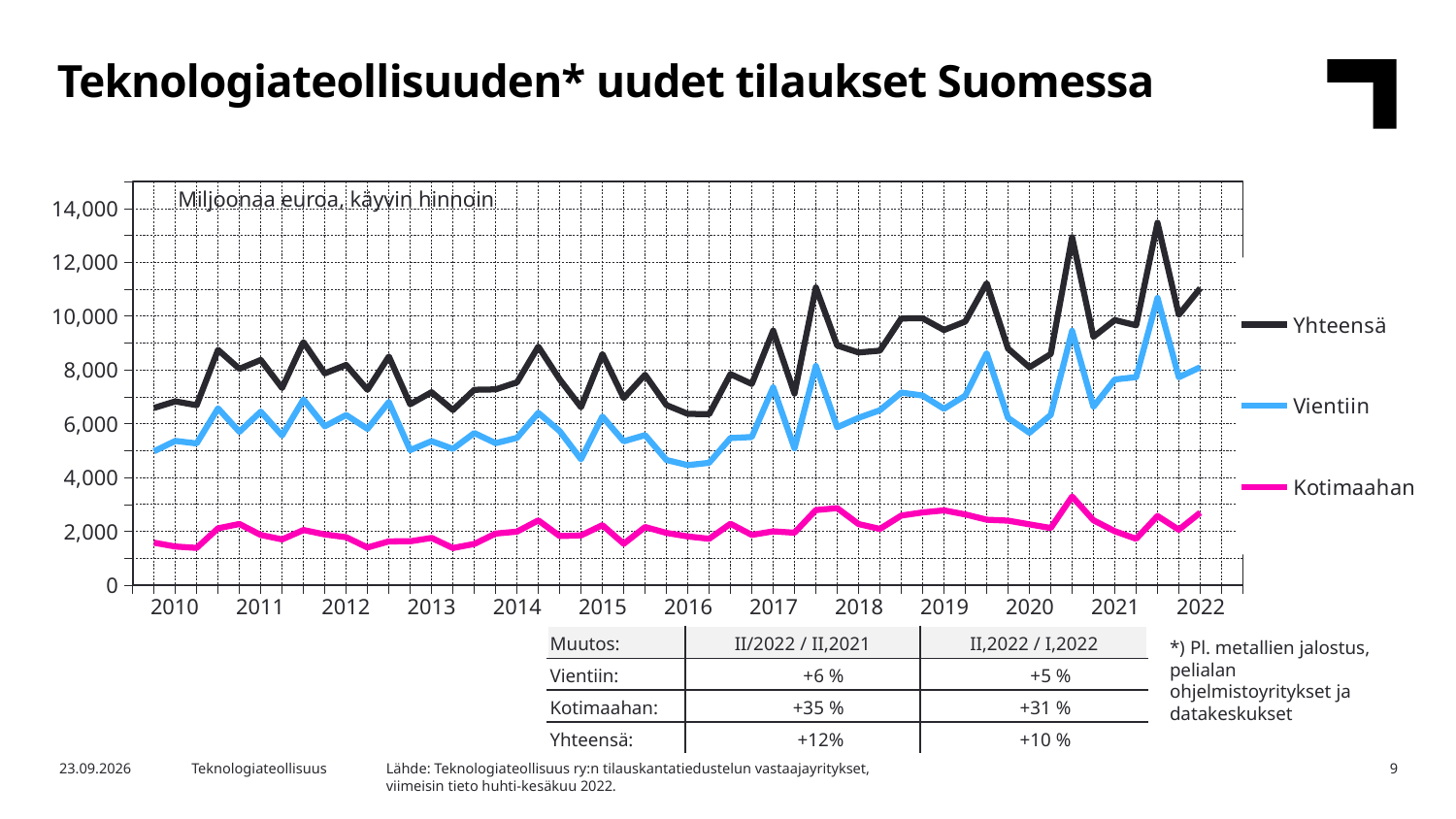
Which series are listed in the legend? Yhteensä, Vientiin, Kotimaahan Is the Kotimaahan value at the start of 2010 greater or less than 2,000? less Is the peak value of the Vientiin line in 2021 greater or less than 10,000? greater Which series has the lowest values throughout the chart? Kotimaahan How many years are labelled on the x axis? 13 Which series has the highest values throughout the chart? Yhteensä What kind of chart is shown on the slide? Line chart What unit is stated inside the chart area? Miljoonaa euroa, käyvin hinnoin Is the lowest Vientiin value in 2016 greater or less than 6,000? less How many series does the legend list? 3 In 2022, which is larger, the Vientiin value or the Kotimaahan value? Vientiin